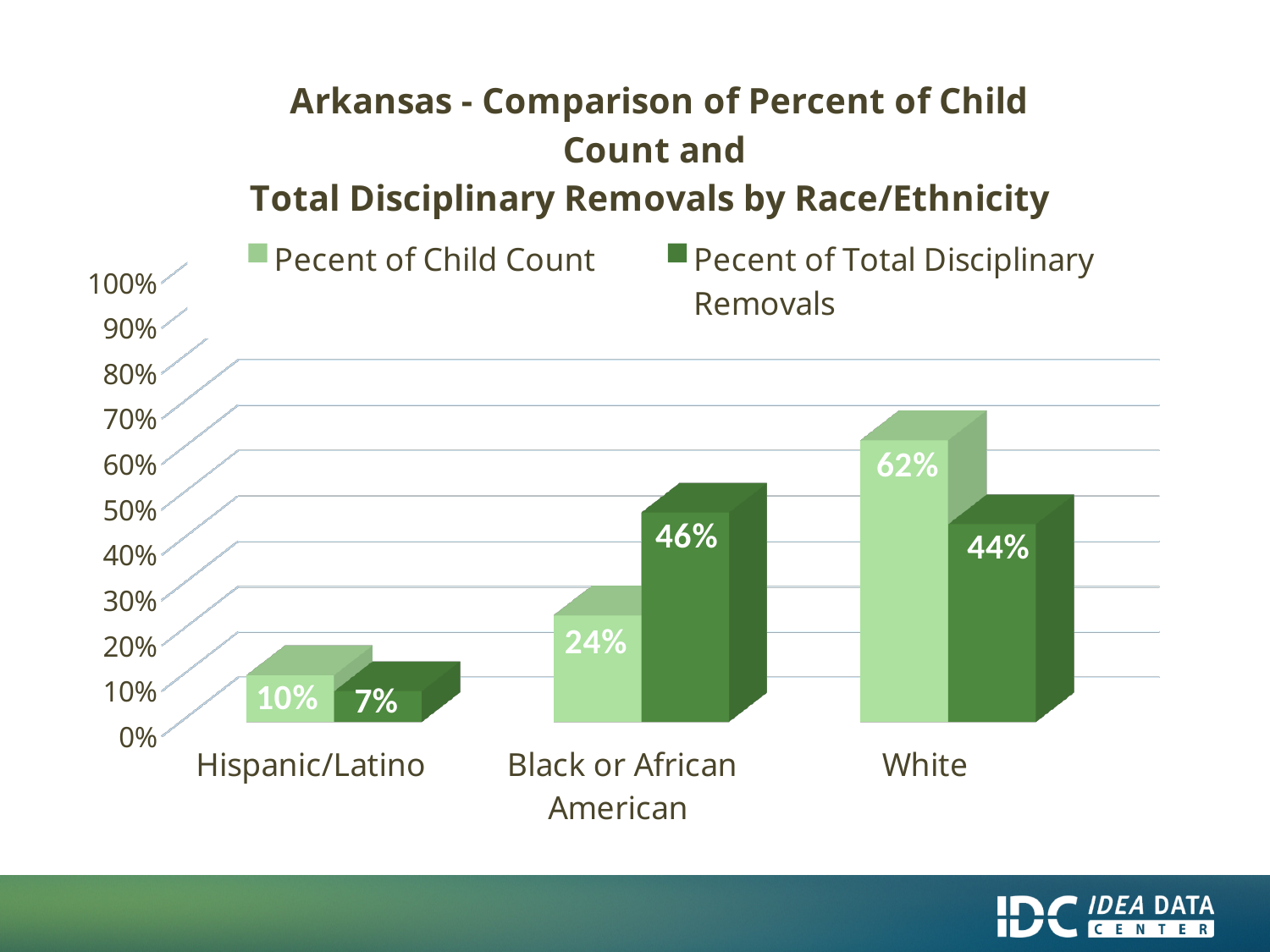
What is the difference between the Percent of Total Disciplinary Removals and the Percent of Child Count for Black or African American? 22% Which race/ethnicity has the lowest Percent of Total Disciplinary Removals? Hispanic/Latino What is the Percent of Total Disciplinary Removals for Black or African American? 46% Is the Percent of Child Count for Black or African American greater or less than 30%? less What kind of chart is shown on the slide? Bar chart For White, which is larger: the Percent of Child Count or the Percent of Total Disciplinary Removals? Percent of Child Count Which race/ethnicity has the highest Percent of Child Count? White How many series does the legend list? 2 What is the Percent of Child Count for White? 62% How many race/ethnicity categories are shown on the chart? 3 What is the Percent of Total Disciplinary Removals for Hispanic/Latino? 7% Which state is named in the chart title? Arkansas